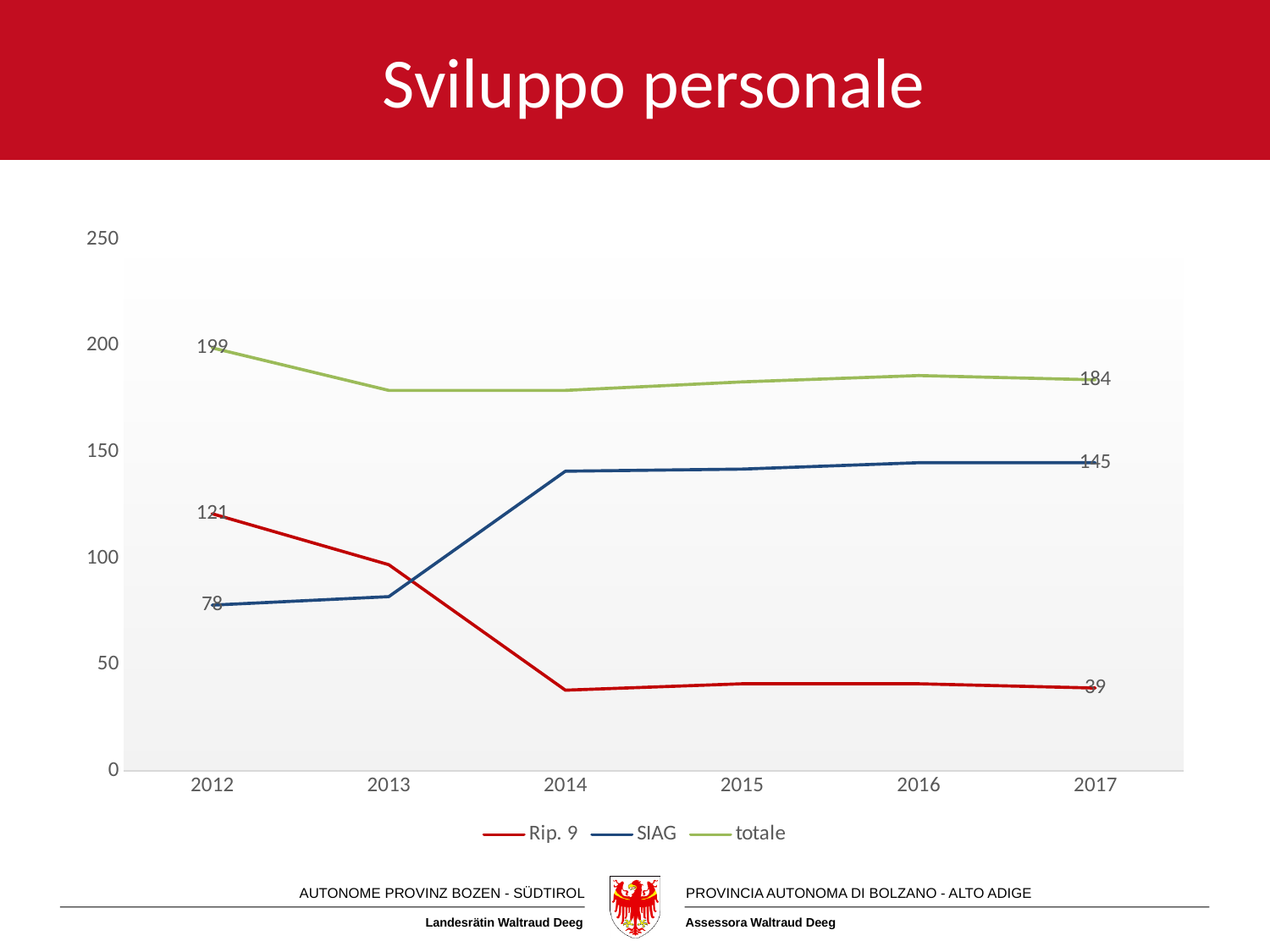
Which series has the higher value in 2012, Rip. 9 or SIAG? Rip. 9 What is the value of Rip. 9 in 2017? 39 How many series does the legend list? 3 Does the Rip. 9 series rise or fall from 2012 to 2017? fall What is the difference between SIAG and Rip. 9 in 2017? 106 What is the value of totale in 2012? 199 Is the value for SIAG in 2014 greater or less than 100? greater How many years are shown on the x axis? 6 By how much did the totale value change from 2012 to 2017? 15 What is the value of SIAG in 2017? 145 What is the value of Rip. 9 in 2012? 121 What type of chart is shown on the slide? line chart